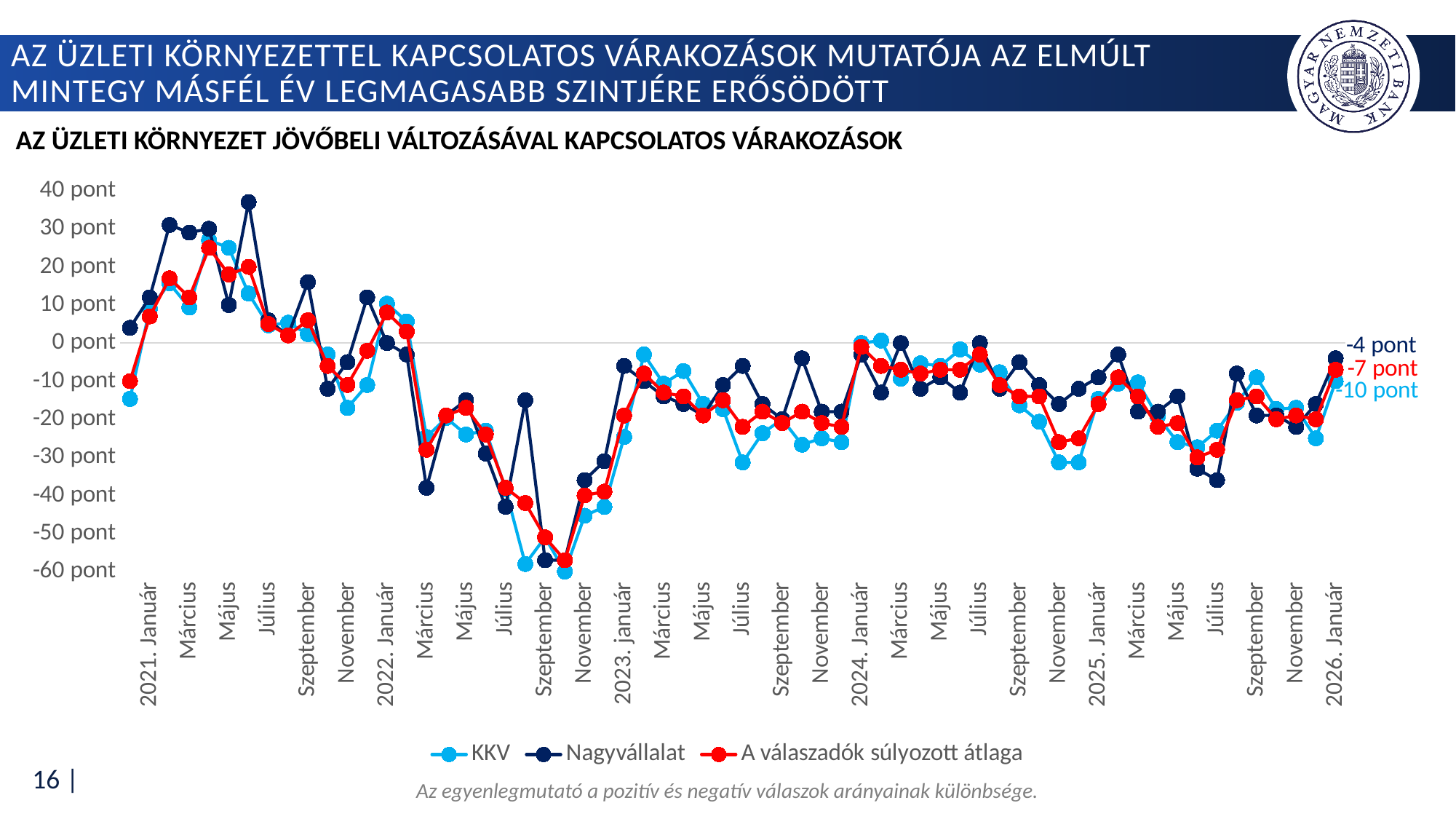
What colour is the KKV series in the legend? light blue Do the KKV values rise or fall between 2022. Január and 2022 Szeptember? fall At 2026. Január, which series has the highest value? Nagyvállalat What is the difference between the Nagyvállalat and KKV values at 2026. Január? 6 pont What kind of chart is shown on the slide? line chart What is the value of A válaszadók súlyozott átlaga at 2026. Január? -7 pont What is the value of the Nagyvállalat series at 2026. Január? -4 pont What is the value of the KKV series at 2026. Január? -10 pont Is the Nagyvállalat value in 2021 Március greater or less than 20 pont? greater At 2026. Január, which series has the lowest value? KKV How many series does the legend list? 3